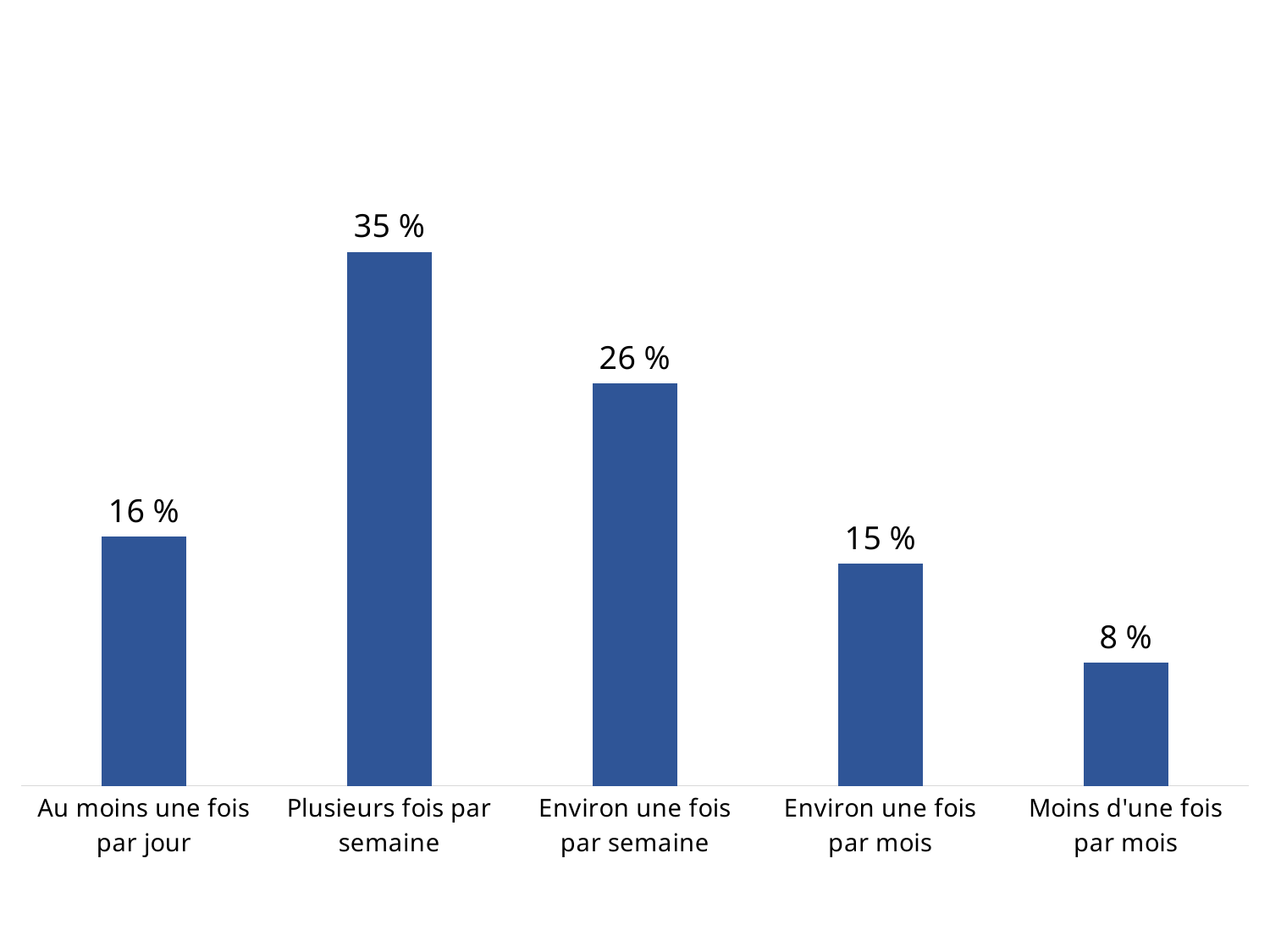
What is the value for "Moins d'une fois par mois"? 8 % What kind of chart is shown on the slide? Bar chart How many categories are shown in the chart? 5 What is the value for "Environ une fois par mois"? 15 % Which category has the lowest value? Moins d'une fois par mois Which is larger, the value for "Environ une fois par semaine" or the value for "Environ une fois par mois"? Environ une fois par semaine What is the difference between the values for "Plusieurs fois par semaine" and "Environ une fois par semaine"? 9 % Which category has the highest value? Plusieurs fois par semaine What is the difference between the values for "Au moins une fois par jour" and "Moins d'une fois par mois"? 8 % What is the value for "Au moins une fois par jour"? 16 % What colour are the bars in the chart? Blue What is the value for "Plusieurs fois par semaine"? 35 %